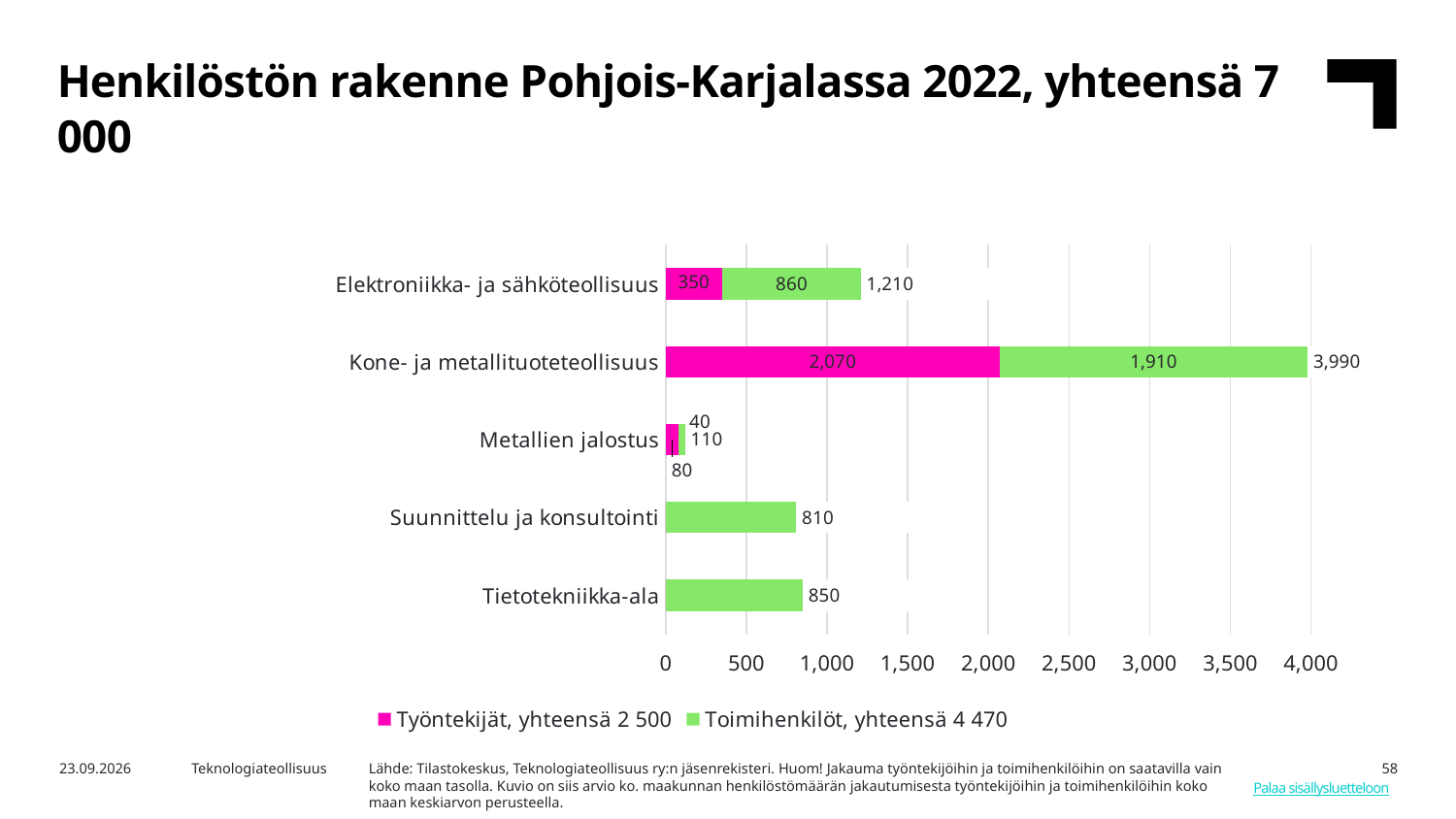
What total does the legend give for Toimihenkilöt? 4 470 What type of chart is shown on the slide? bar chart How many categories are shown on the chart? 5 Which category has the highest total? Kone- ja metallituoteteollisuus Which category has the lowest total? Metallien jalostus What is the total of the stacked bar for Elektroniikka- ja sähköteollisuus? 1,210 What is the total of the stacked bar for Kone- ja metallituoteteollisuus? 3,990 Which is larger: the Työntekijät value or the Toimihenkilöt value for Kone- ja metallituoteteollisuus? Työntekijät What is the Työntekijät value for Kone- ja metallituoteteollisuus? 2,070 What is the Toimihenkilöt value for Elektroniikka- ja sähköteollisuus? 860 How many series does the legend list? 2 What is the difference between the Toimihenkilöt values for Tietotekniikka-ala and Suunnittelu ja konsultointi? 40